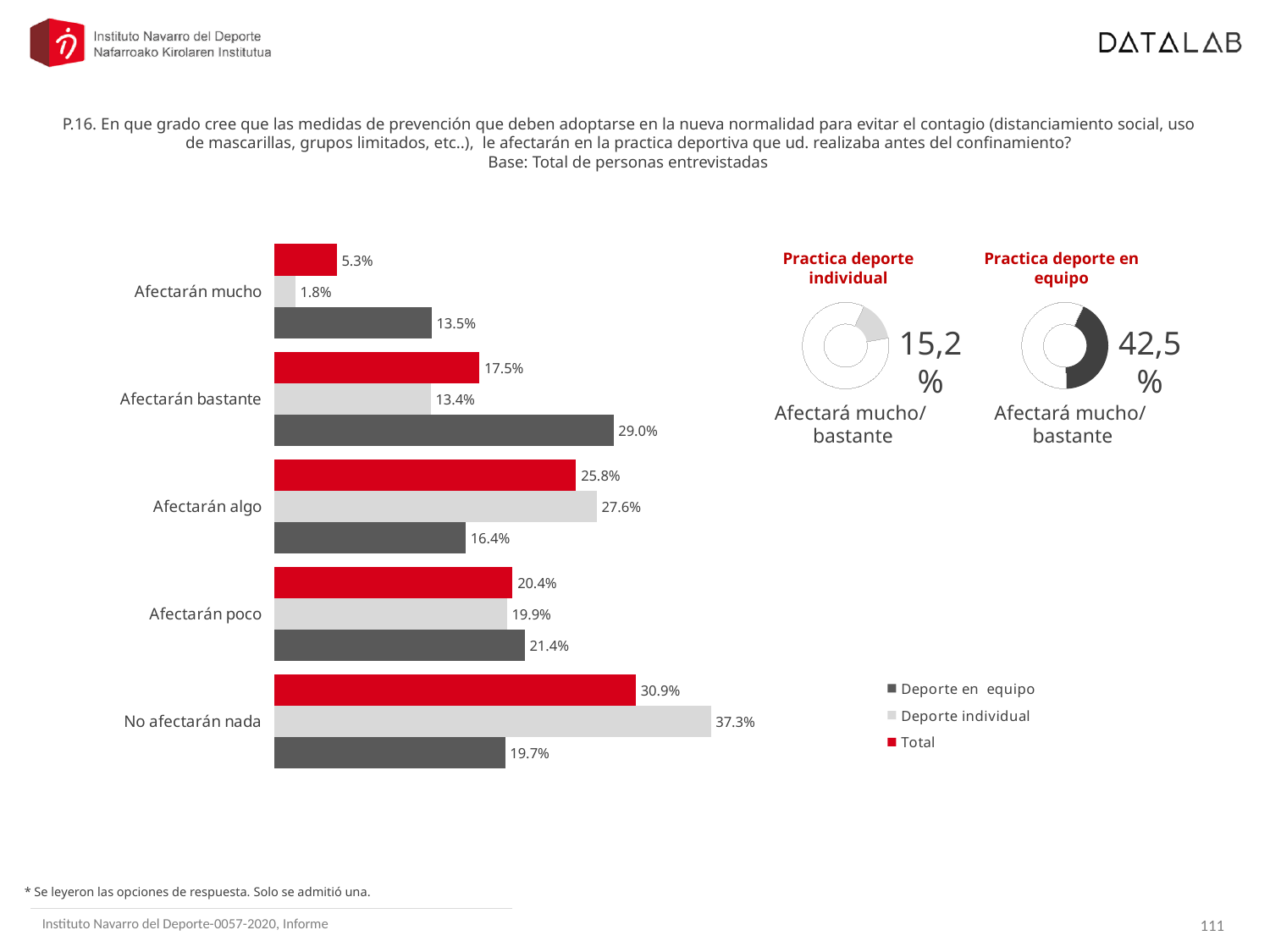
How many series does the bar chart's legend list? 3 In the bar chart, what is the 'Deporte individual' value for 'Afectarán mucho'? 1.8% In the bar chart, what is the 'Deporte en equipo' value for 'Afectarán bastante'? 29.0% In the 'Practica deporte en equipo' donut chart, what percentage answered 'Afectará mucho/bastante'? 42,5% In the bar chart, which category has the lowest Total value? Afectarán mucho In the bar chart, for 'Afectarán algo', which is larger: the 'Deporte individual' value or the 'Deporte en equipo' value? Deporte individual In the bar chart, what is the difference between the 'Deporte individual' and 'Deporte en equipo' values for 'No afectarán nada'? 17.6% In the bar chart, what is the Total value for 'No afectarán nada'? 30.9% What type of chart is the main chart on the left of the slide? Bar chart In the 'Practica deporte individual' donut chart, what percentage answered 'Afectará mucho/bastante'? 15,2% In the bar chart, which category has the highest 'Deporte individual' value? No afectarán nada How many response categories are shown in the bar chart? 5